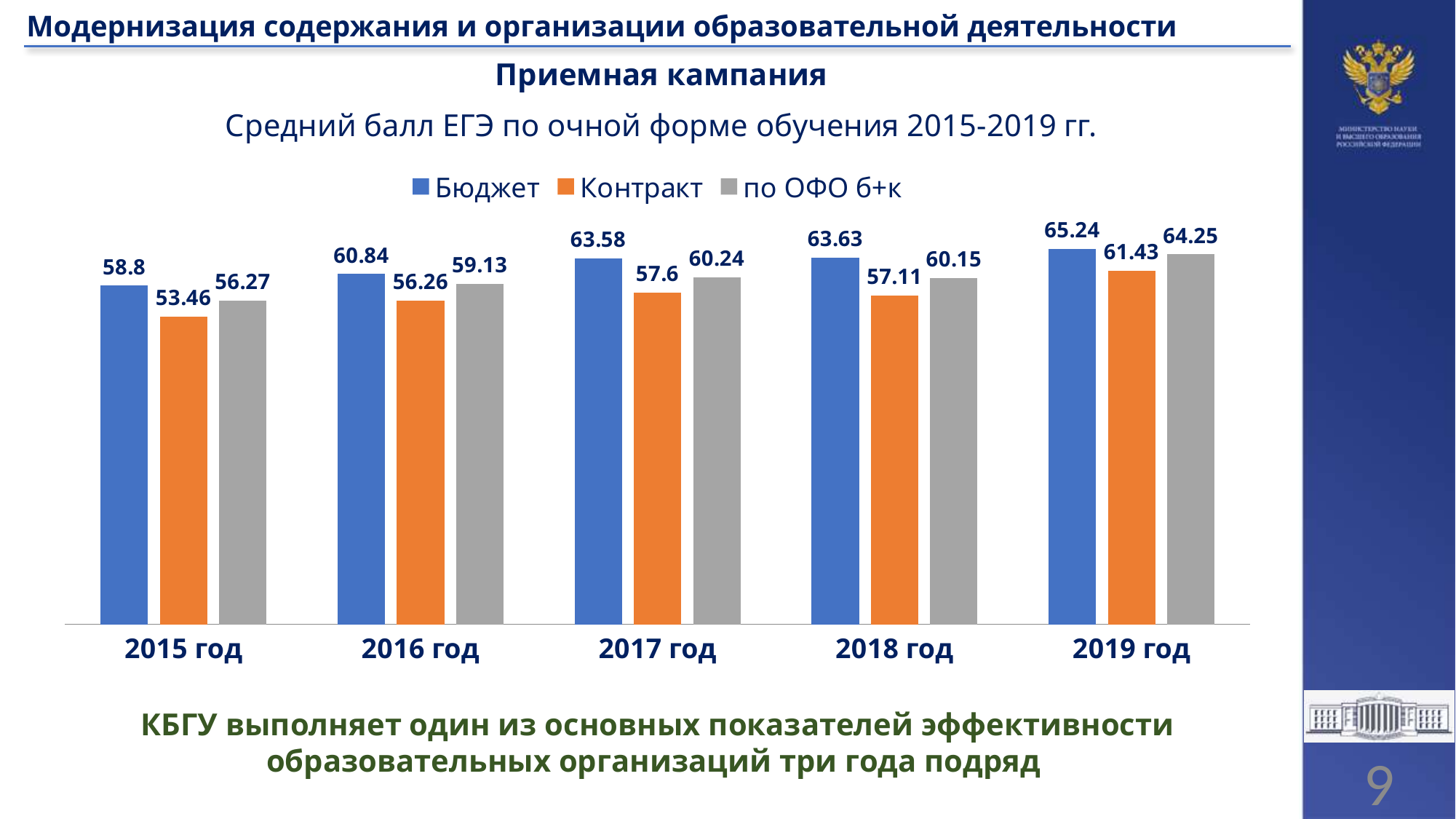
What is the value for Контракт in 2018 год? 57.11 In which year is the Бюджет value highest? 2019 год How many years are shown on the x axis? 5 What is the difference between the Бюджет and Контракт values in 2019 год? 3.81 In which year is the Контракт value lowest? 2015 год Do the Бюджет values rise or fall from 2015 год to 2019 год? rise How many series does the legend list? 3 Which is larger in 2017 год: Бюджет or по ОФО б+к? Бюджет What is the value for по ОФО б+к in 2019 год? 64.25 What colour represents the Контракт series? orange What is the value for Бюджет in 2015 год? 58.8 What kind of chart is shown on the slide? bar chart